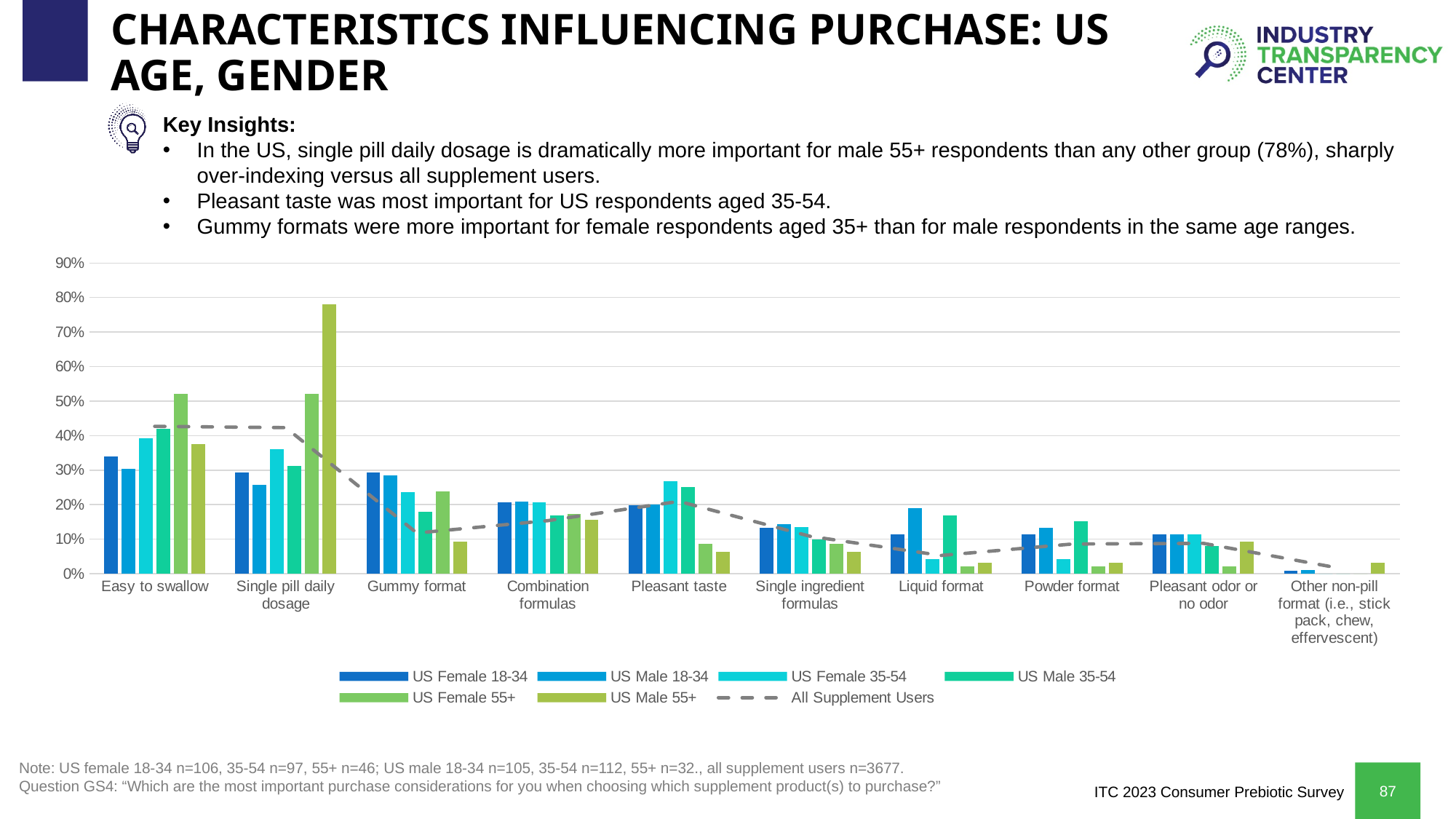
Which category contains the tallest bar in the chart? Single pill daily dosage How many series does the chart legend list? 7 What kind of chart is shown on the slide? Combination bar and line chart Is the value for US Female 18-34 in the Other non-pill format category greater or less than 10%? less In the Liquid format category, which is larger: US Male 18-34 or US Female 35-54? US Male 18-34 How many purchase characteristics (categories) are shown on the x axis of the chart? 10 Is the value for US Female 55+ in the Easy to swallow category greater or less than 40%? greater Which category has the lowest values overall across the series? Other non-pill format (i.e., stick pack, chew, effervescent) Which series has the tallest bar in the Single pill daily dosage category? US Male 55+ Is the value for US Male 55+ in the Single pill daily dosage category greater or less than 70%? greater In the Gummy format category, which is larger: US Female 55+ or US Male 55+? US Female 55+ Which series is drawn as a dashed line rather than bars? All Supplement Users